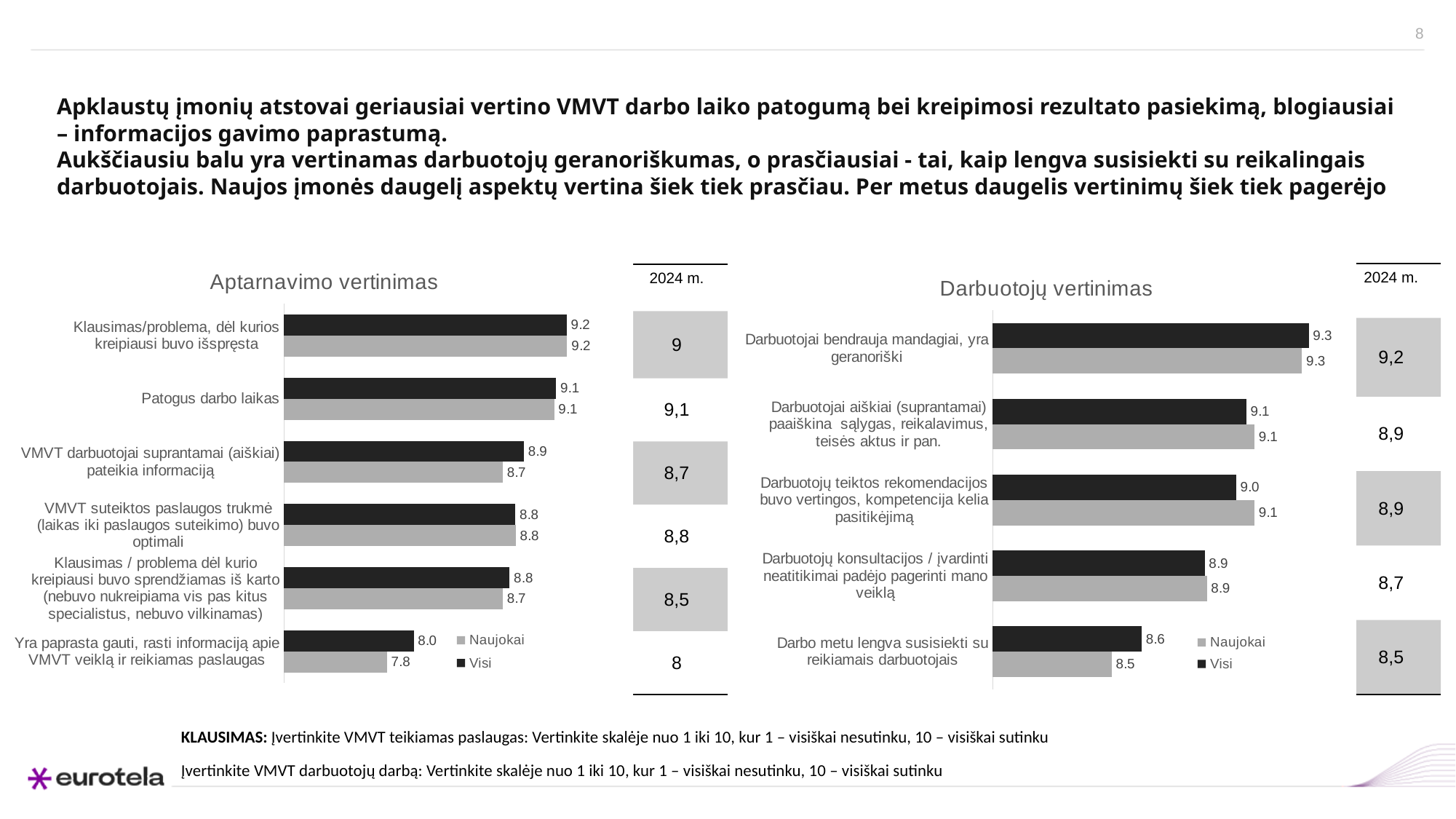
In the 'Aptarnavimo vertinimas' chart, what is the 'Visi' value for 'Patogus darbo laikas'? 9.1 In the 'Aptarnavimo vertinimas' chart, what is the 'Naujokai' value for 'Yra paprasta gauti, rasti informaciją apie VMVT veiklą ir reikiamas paslaugas'? 7.8 In the 'Darbuotojų vertinimas' chart, which is larger for 'Darbuotojų teiktos rekomendacijos buvo vertingos, kompetencija kelia pasitikėjimą': the 'Visi' value or the 'Naujokai' value? Naujokai In the 'Darbuotojų vertinimas' chart, which category has the highest 'Visi' value? Darbuotojai bendrauja mandagiai, yra geranoriški How many series does the legend of the 'Darbuotojų vertinimas' chart list? 2 In the 'Aptarnavimo vertinimas' chart, which category has the lowest 'Visi' value? Yra paprasta gauti, rasti informaciją apie VMVT veiklą ir reikiamas paslaugas In the 'Darbuotojų vertinimas' chart, what is the 'Visi' value for 'Darbuotojų teiktos rekomendacijos buvo vertingos, kompetencija kelia pasitikėjimą'? 9.0 In the 'Aptarnavimo vertinimas' chart, how many categories are shown? 6 In the 'Darbuotojų vertinimas' chart, how many categories are shown? 5 What type of chart is 'Aptarnavimo vertinimas'? Bar chart In the 'Darbuotojų vertinimas' chart, what is the 'Naujokai' value for 'Darbo metu lengva susisiekti su reikiamais darbuotojais'? 8.5 In the 'Aptarnavimo vertinimas' chart, what is the difference between the 'Visi' and 'Naujokai' values for 'VMVT darbuotojai suprantamai (aiškiai) pateikia informaciją'? 0.2